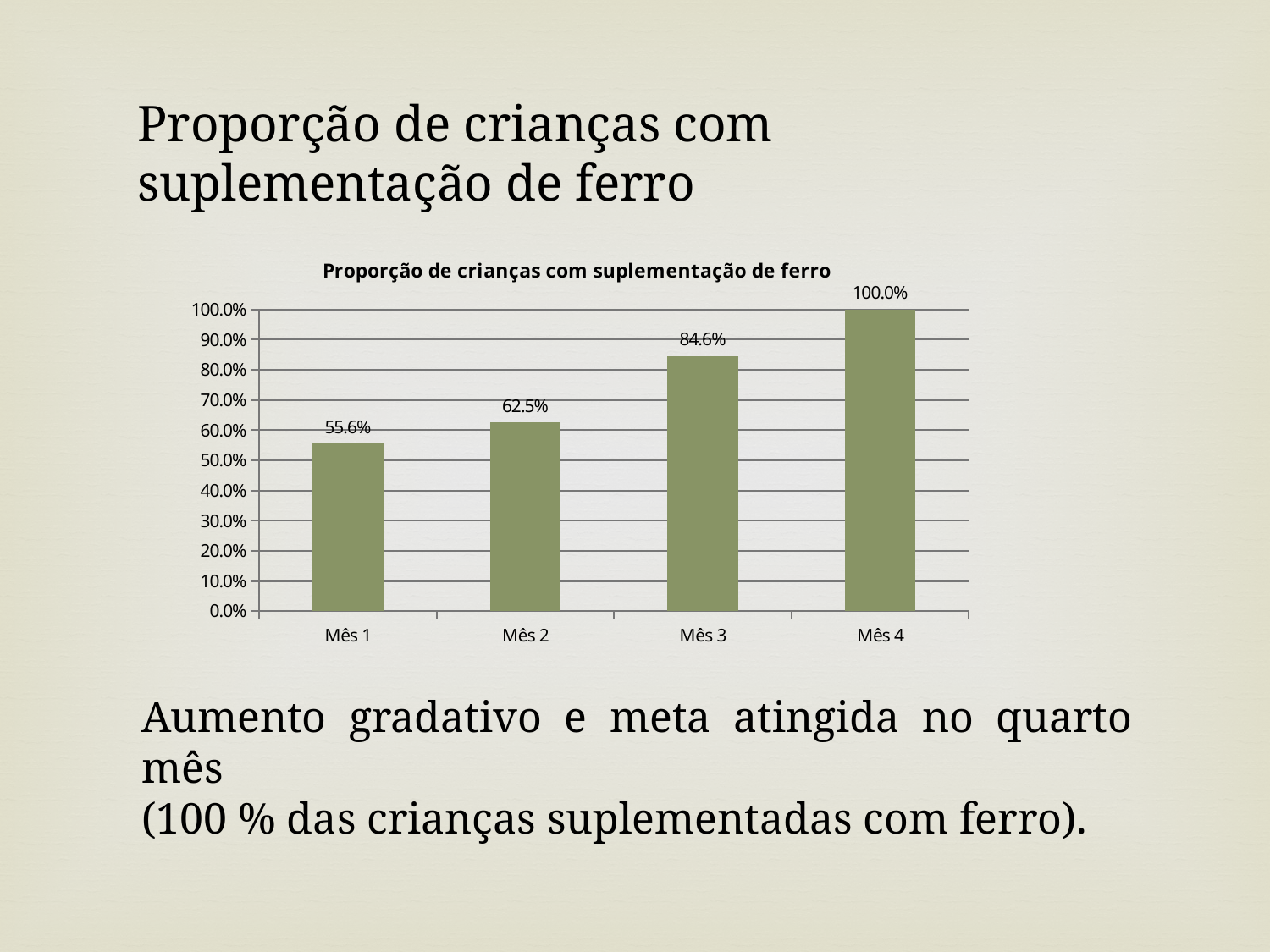
What is the value for Mês 4? 100.0% What is the difference between the values for Mês 3 and Mês 2? 22.1% How many months are shown on the x axis? 4 Which is larger, the value for Mês 2 or the value for Mês 3? Mês 3 What is the value for Mês 1? 55.6% What is the value for Mês 3? 84.6% Do the values rise or fall from Mês 1 to Mês 4? Rise Which month has the highest proportion? Mês 4 Which month has the lowest proportion? Mês 1 What is the value for Mês 2? 62.5% What kind of chart is shown on the slide? Bar chart What is the difference between the values for Mês 4 and Mês 1? 44.4%